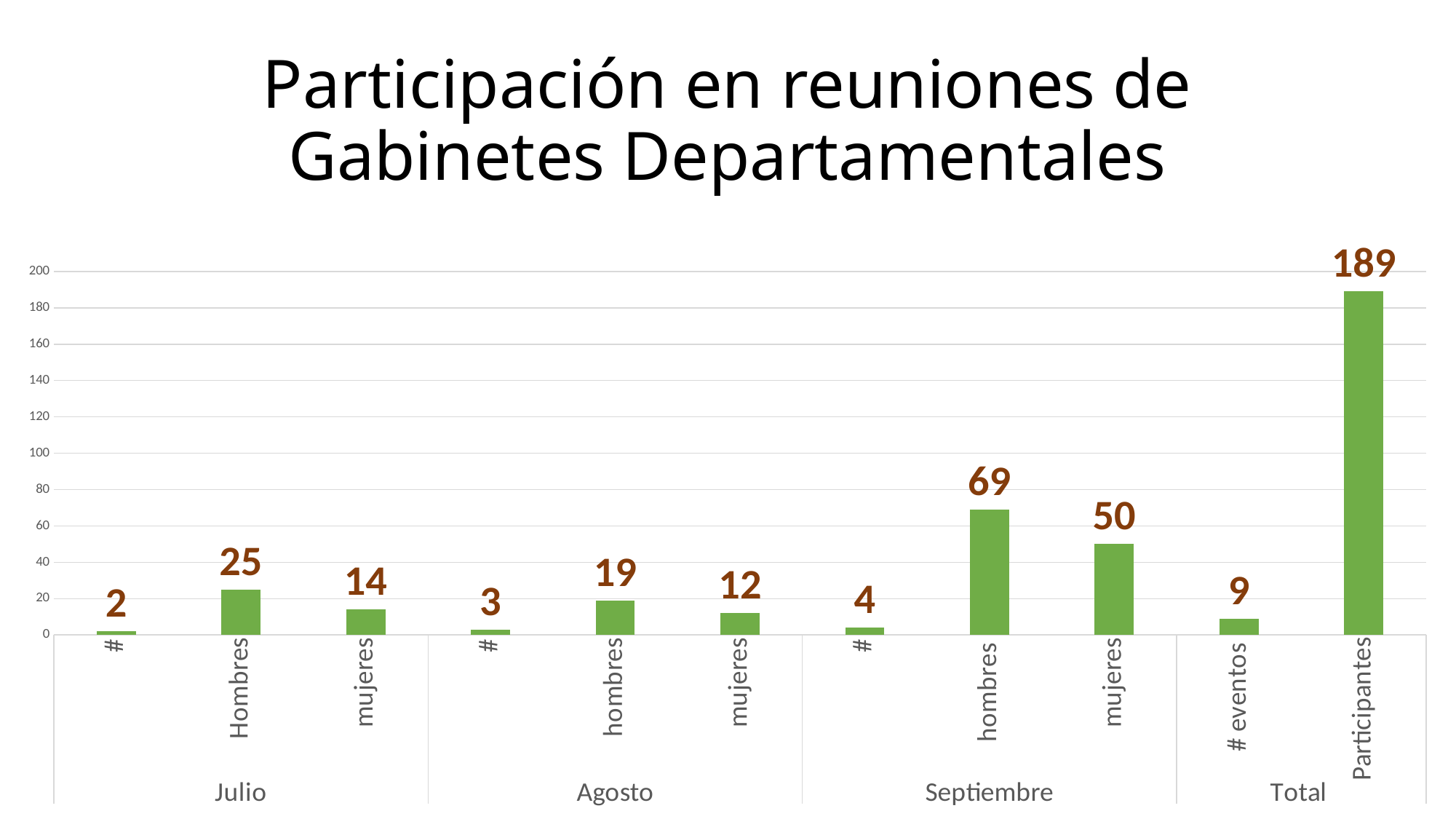
What is the value for # eventos in the Total group? 9 What is the value for Participantes in the Total group? 189 What is the title of the slide? Participación en reuniones de Gabinetes Departamentales How many bars are plotted in the chart? 11 Which bar has the highest value? Participantes (Total) Which is larger, hombres in Agosto or mujeres in Agosto? hombres in Agosto What is the difference between hombres and mujeres in Septiembre? 19 Is the value for hombres in Septiembre greater or less than 60? greater What kind of chart is shown on the slide? bar chart Which bar has the lowest value? # (Julio) What is the value for Hombres in Julio? 25 What is the value for mujeres in Septiembre? 50